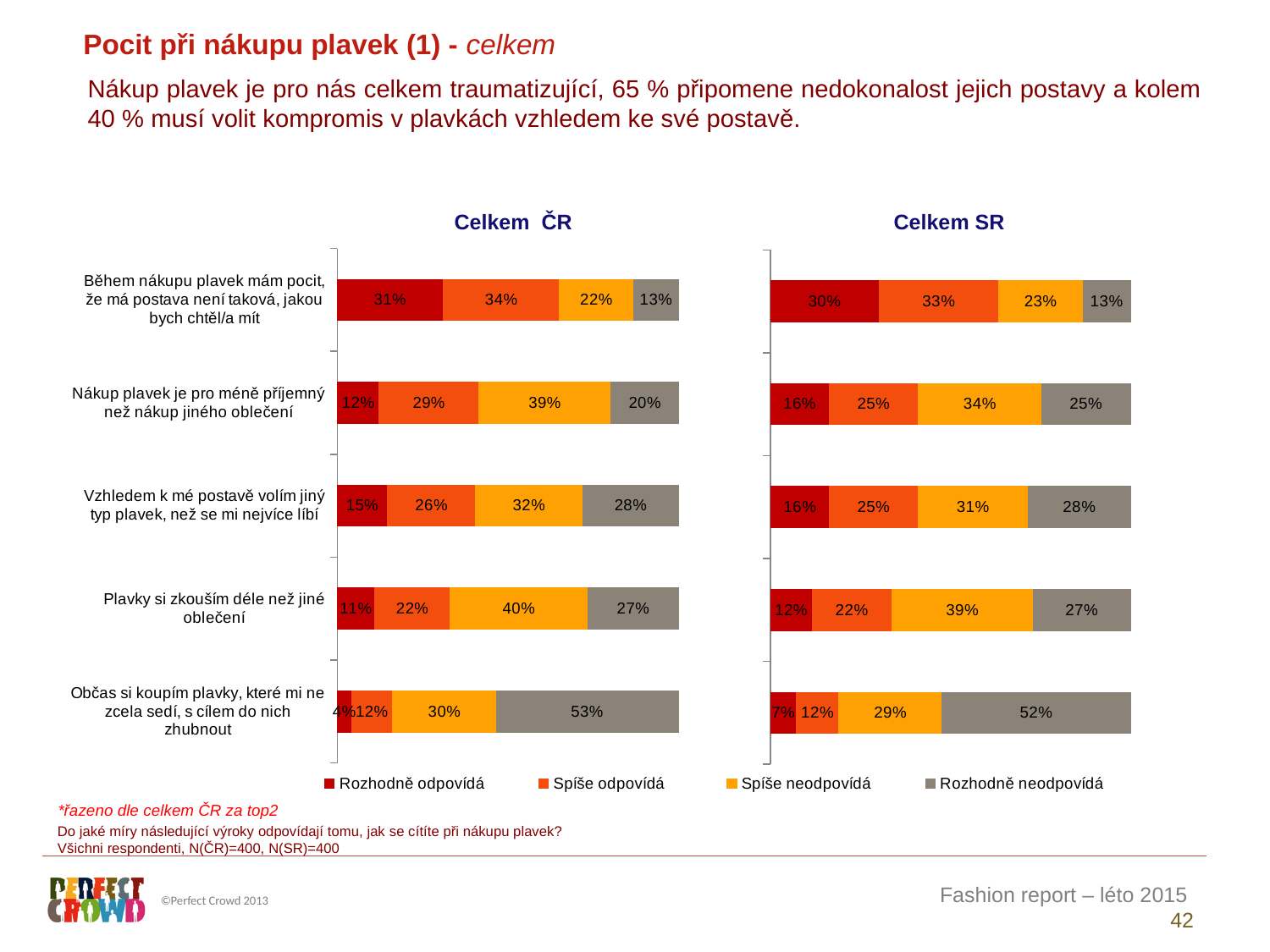
How many series does the legend list? 4 In the Celkem ČR chart, what is the difference between the Spíše neodpovídá value for "Nákup plavek je pro méně příjemný než nákup jiného oblečení" (39%) and the Spíše odpovídá value for the same statement (29%)? 10% In the Celkem SR chart, what is the value of Spíše odpovídá for "Nákup plavek je pro méně příjemný než nákup jiného oblečení"? 25% What is the title of the chart on the right side of the slide? Celkem SR How many statements (categories) are shown in the Celkem ČR chart? 5 In the Celkem SR chart, what is the value of Rozhodně neodpovídá for "Občas si koupím plavky, které mi ne zcela sedí, s cílem do nich zhubnout"? 52% In the Celkem SR chart, which statement has the lowest Rozhodně odpovídá value? Občas si koupím plavky, které mi ne zcela sedí, s cílem do nich zhubnout Which is larger: the Rozhodně neodpovídá value for "Nákup plavek je pro méně příjemný než nákup jiného oblečení" in the Celkem ČR chart or in the Celkem SR chart? Celkem SR In the Celkem ČR chart, what is the value of Spíše neodpovídá for "Plavky si zkouším déle než jiné oblečení"? 40% What type of chart is the Celkem SR chart? Stacked bar chart In the Celkem ČR chart, what is the value of Rozhodně odpovídá for "Během nákupu plavek mám pocit, že má postava není taková, jakou bych chtěl/a mít"? 31% In the Celkem ČR chart, which statement has the highest Rozhodně neodpovídá value? Občas si koupím plavky, které mi ne zcela sedí, s cílem do nich zhubnout